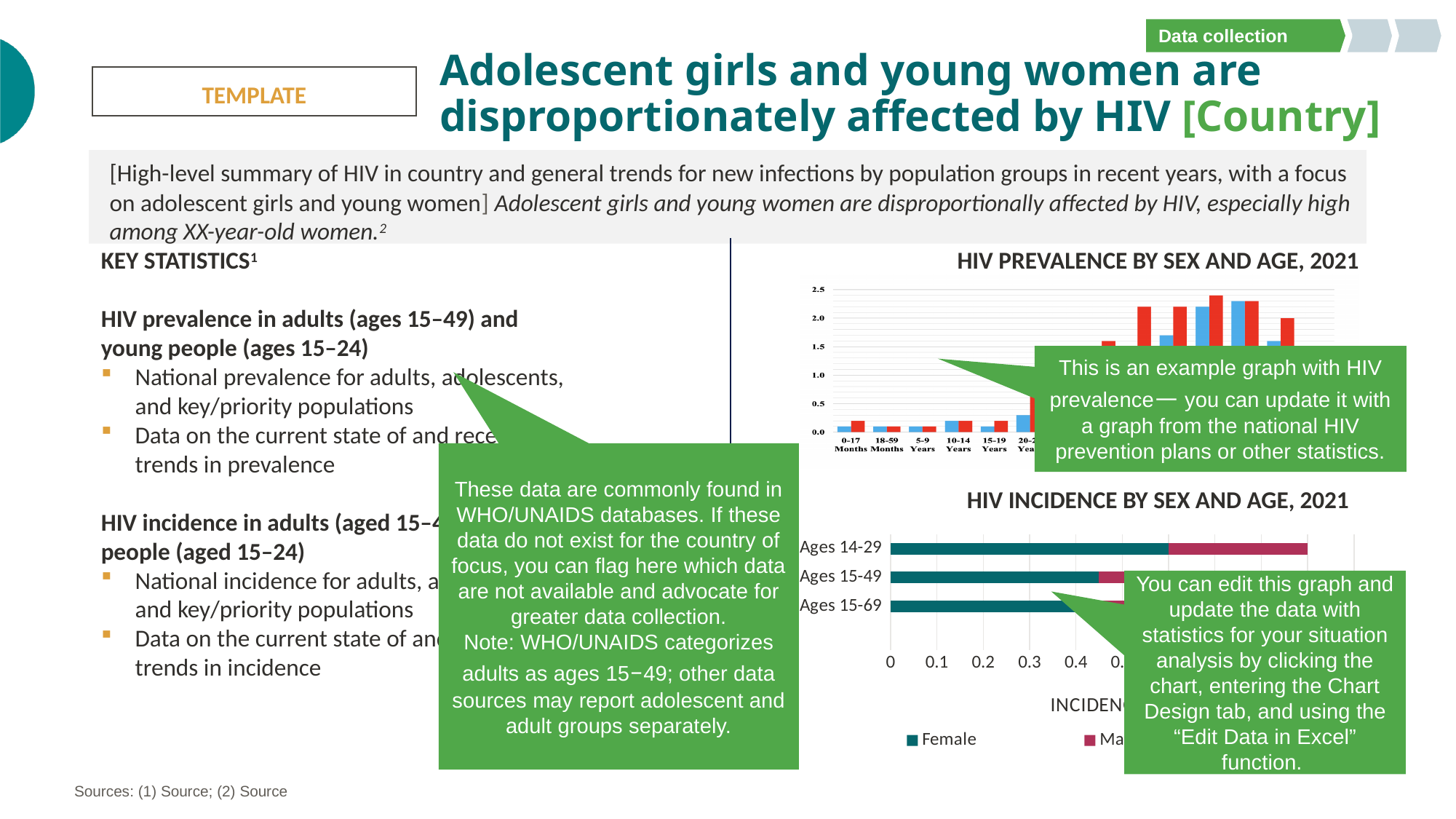
How many age categories are shown in the HIV INCIDENCE BY SEX AND AGE, 2021 chart? 3 In the HIV INCIDENCE BY SEX AND AGE, 2021 chart, which age category has the shortest Female bar? Ages 15-69 What kind of chart is the HIV INCIDENCE BY SEX AND AGE, 2021 chart? bar chart In the HIV PREVALENCE BY SEX AND AGE, 2021 chart, is the tallest bar greater or less than 2.0? greater What kind of chart is the HIV PREVALENCE BY SEX AND AGE, 2021 chart? bar chart In the HIV INCIDENCE BY SEX AND AGE, 2021 chart, is the Female value for Ages 15-49 greater or less than 0.4? greater In the HIV INCIDENCE BY SEX AND AGE, 2021 chart, is the Female value for Ages 15-69 greater or less than 0.3? greater In the HIV INCIDENCE BY SEX AND AGE, 2021 chart, what is the first series listed in the legend? Female In the HIV INCIDENCE BY SEX AND AGE, 2021 chart, is the Female value larger for Ages 14-29 or for Ages 15-49? Ages 14-29 In the HIV INCIDENCE BY SEX AND AGE, 2021 chart, which age category has the longest Female bar? Ages 14-29